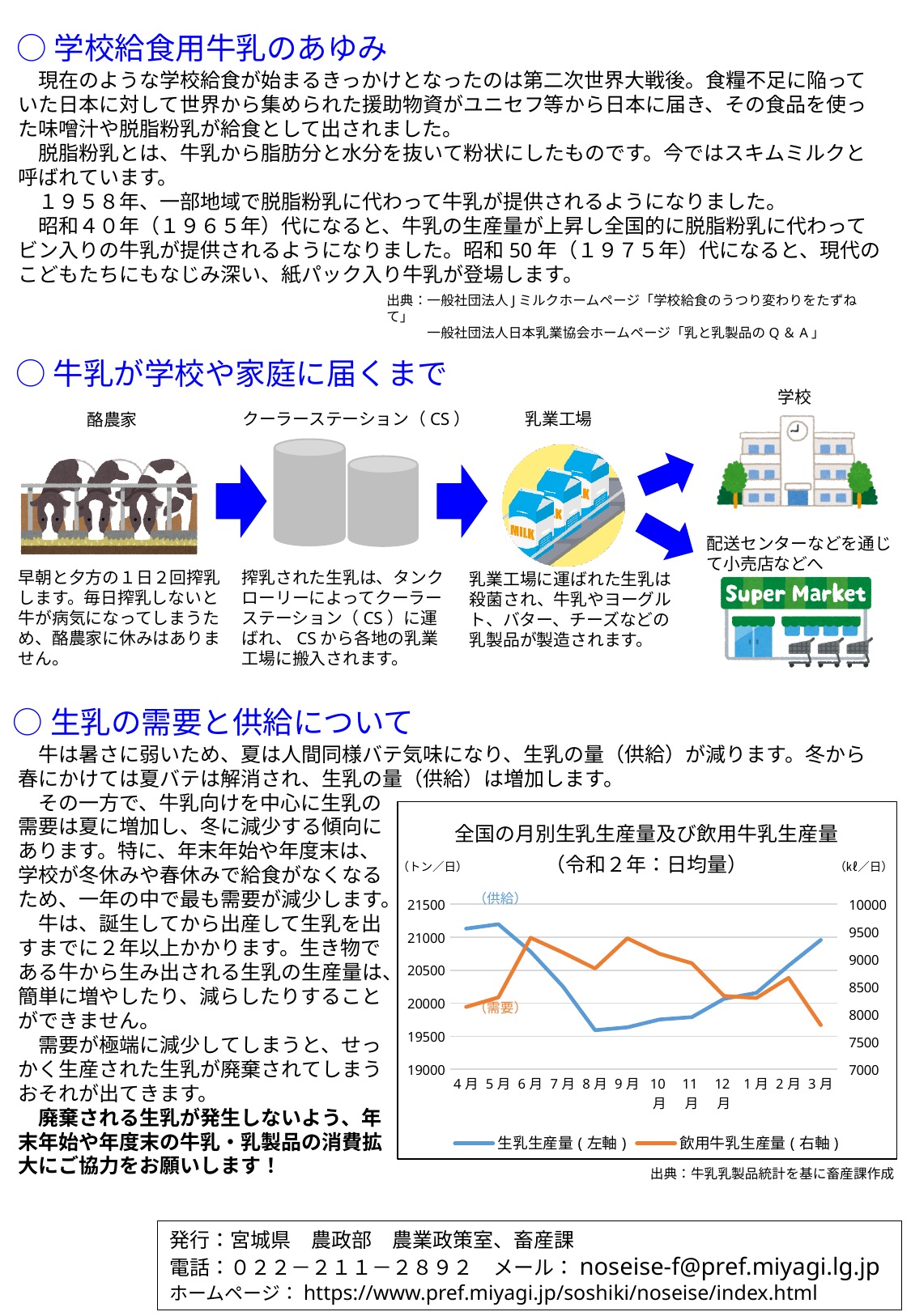
What kind of chart is shown on the slide? line chart Which is larger for 生乳生産量 (left axis): the value for 4月 or the value for 8月? 4月 Which month has the lowest value of 飲用牛乳生産量 (right axis)? 3月 Does the 生乳生産量 line rise or fall from 8月 to 3月? rise Does the 生乳生産量 line rise or fall from 4月 to 8月? fall Is the value of 生乳生産量 (left axis) for 8月 greater or less than 20000? less Is the value of 飲用牛乳生産量 (right axis) for 3月 greater or less than 8000? less Is the value of 飲用牛乳生産量 (right axis) for 6月 greater or less than 9000? greater What unit is shown for the left axis of the chart? トン／日 How many series does the chart legend list? 2 How many months are plotted along the x axis of the chart? 12